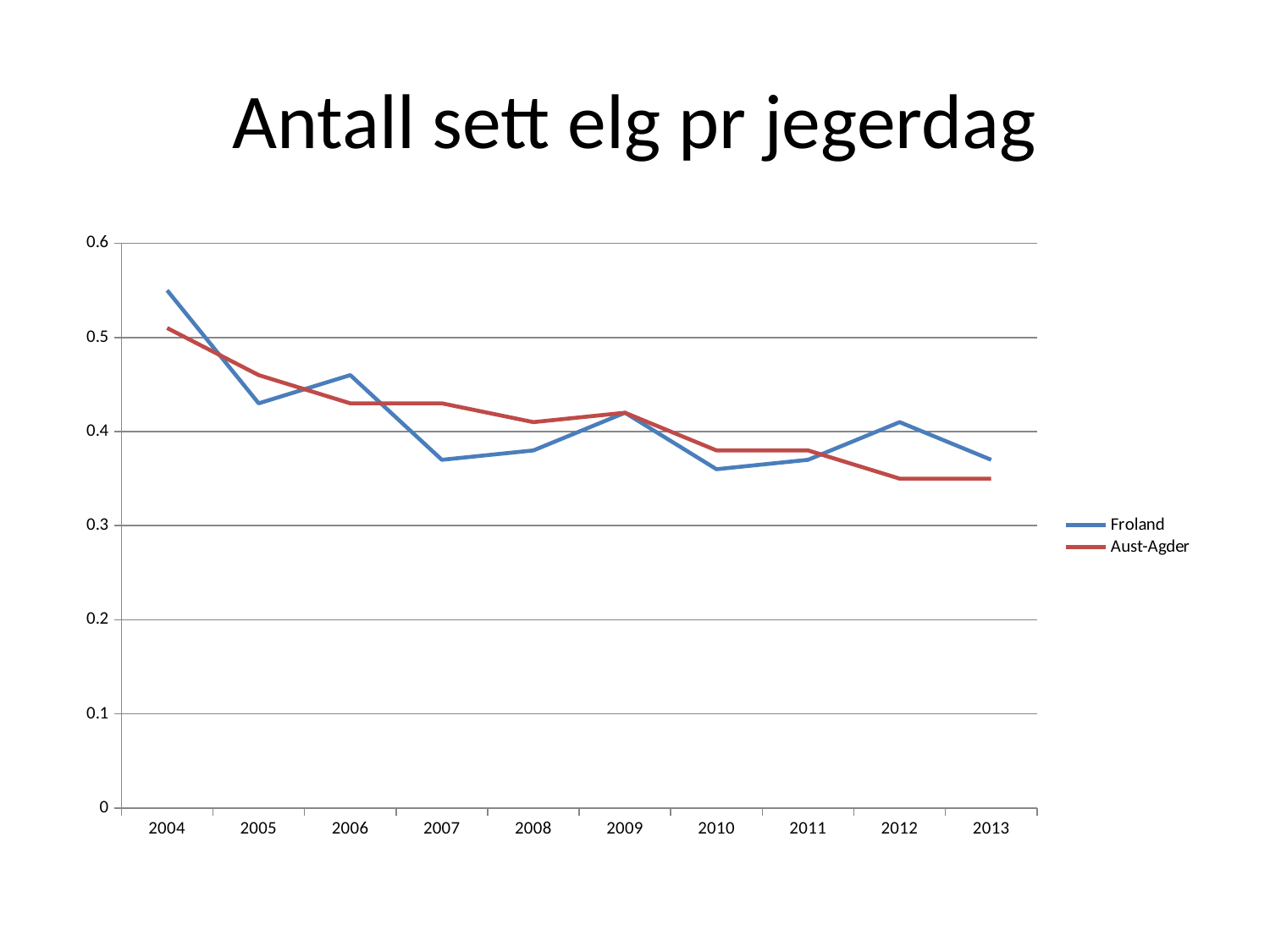
What kind of chart is shown on the slide? Line chart Is the Froland value for 2004 greater or less than 0.5? greater How many years are shown on the x axis? 10 In 2012, which series has the higher value, Froland or Aust-Agder? Froland Overall, does the Aust-Agder line rise or fall from 2004 to 2013? Fall In which year is the Aust-Agder value highest? 2004 In 2007, which series has the higher value, Froland or Aust-Agder? Aust-Agder Is the Aust-Agder value for 2013 greater or less than 0.4? less What is the title of the chart? Antall sett elg pr jegerdag How many series does the legend list? 2 Is the Froland value for 2006 greater or less than 0.4? greater In which year is the Froland value highest? 2004